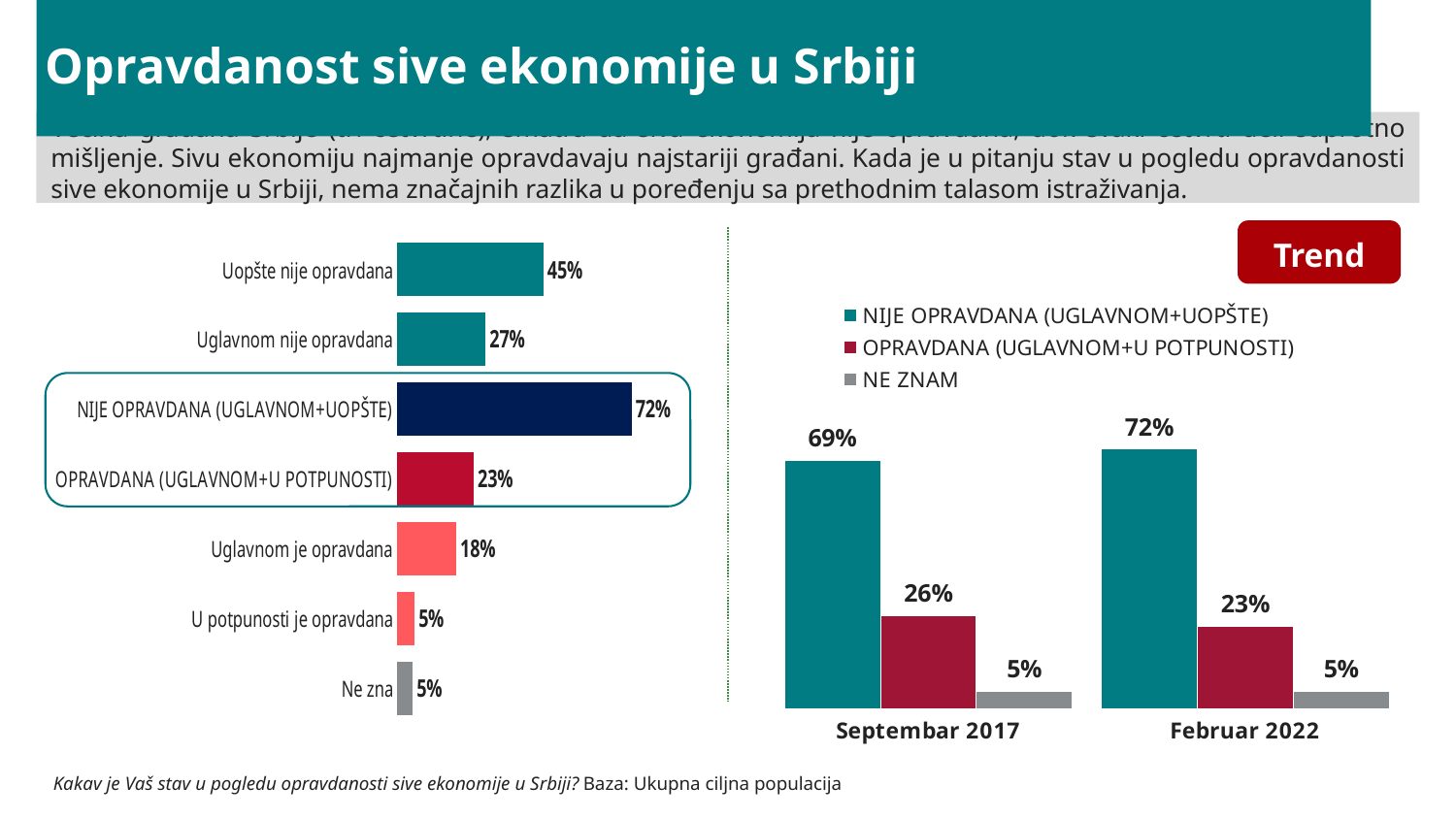
In the right-hand "Trend" chart, what is the value for "OPRAVDANA (UGLAVNOM+U POTPUNOSTI)" in Februar 2022? 23% In the left-hand bar chart, how many categories are shown? 7 In the right-hand "Trend" chart, how many series does the legend list? 3 In the left-hand bar chart, which category has the highest value? NIJE OPRAVDANA (UGLAVNOM+UOPŠTE) What kind of chart is the right-hand "Trend" chart? bar chart In the left-hand bar chart, what is the difference between "Uopšte nije opravdana" and "Uglavnom nije opravdana"? 18% In the right-hand "Trend" chart, did the value for "OPRAVDANA (UGLAVNOM+U POTPUNOSTI)" rise or fall from Septembar 2017 to Februar 2022? fall In the right-hand "Trend" chart, what is the value for "NIJE OPRAVDANA (UGLAVNOM+UOPŠTE)" in Septembar 2017? 69% In the left-hand bar chart, what is the value for "Uopšte nije opravdana"? 45% In the left-hand bar chart, what is the value for "Uglavnom je opravdana"? 18% In the right-hand "Trend" chart, what is the difference between the "NIJE OPRAVDANA (UGLAVNOM+UOPŠTE)" values for Februar 2022 and Septembar 2017? 3% In the left-hand bar chart, which is larger: "Uglavnom nije opravdana" or "Uglavnom je opravdana"? Uglavnom nije opravdana